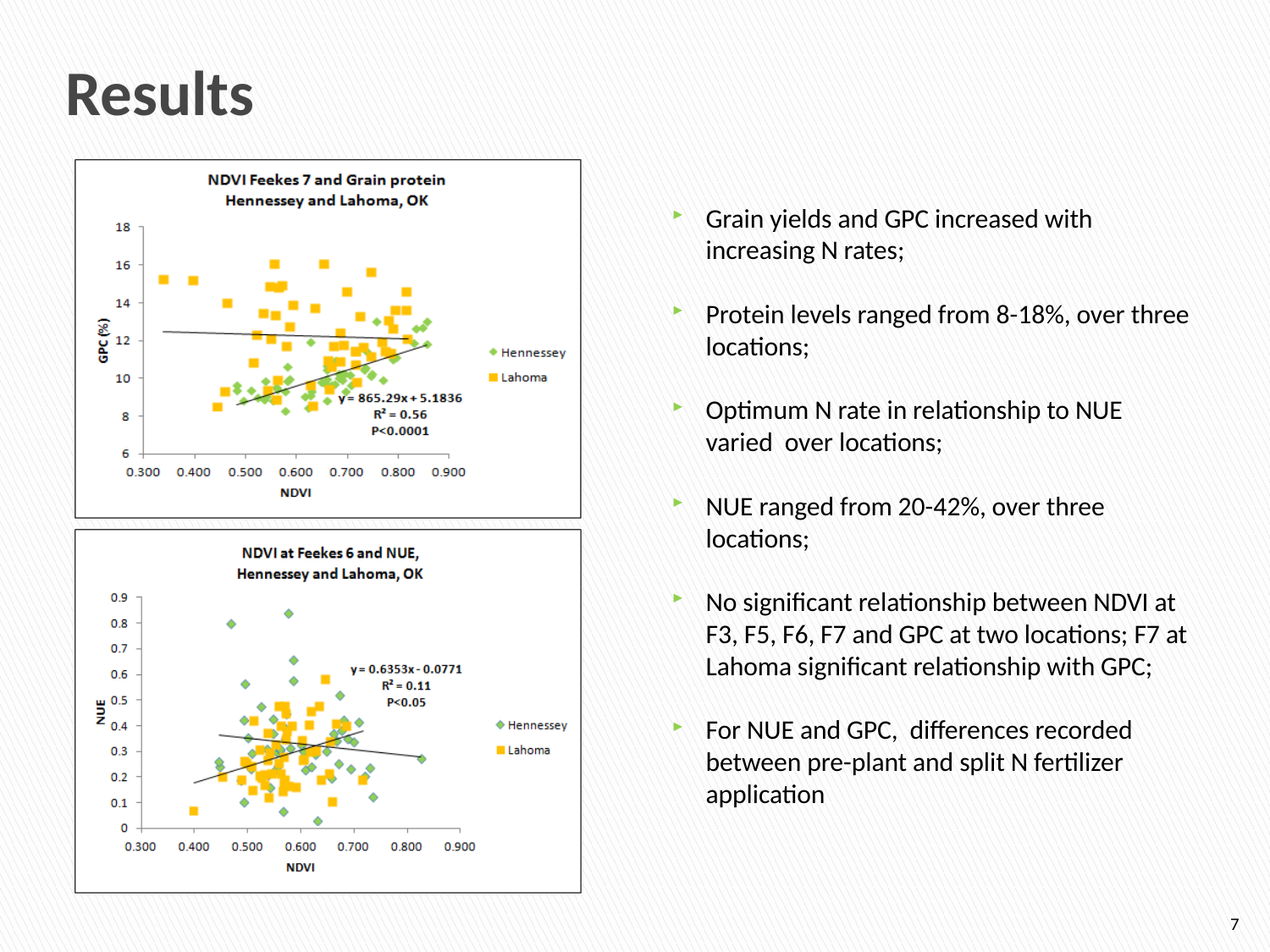
How many series does the legend of the top chart list? 2 In the top chart, what is the equation of the fitted line? y = 865.29x + 5.1836 In the top chart, is the lowest Lahoma GPC value greater or less than 10? less In the bottom chart, what is the equation of the fitted line? y = 0.6353x - 0.0771 How many series does the legend of the bottom chart list? 2 What kind of chart is the bottom chart titled 'NDVI at Feekes 6 and NUE'? scatter chart In the bottom chart, what is the R² value shown for the fitted line? 0.11 What kind of chart is the top chart titled 'NDVI Feekes 7 and Grain protein'? scatter chart In the bottom chart, is the highest Hennessey NUE value greater or less than 0.7? greater In the top chart, what is the R² value shown for the fitted line? 0.56 In the top chart, what is the label of the y axis? GPC (%) In the bottom chart, which two locations are listed in the legend? Hennessey and Lahoma